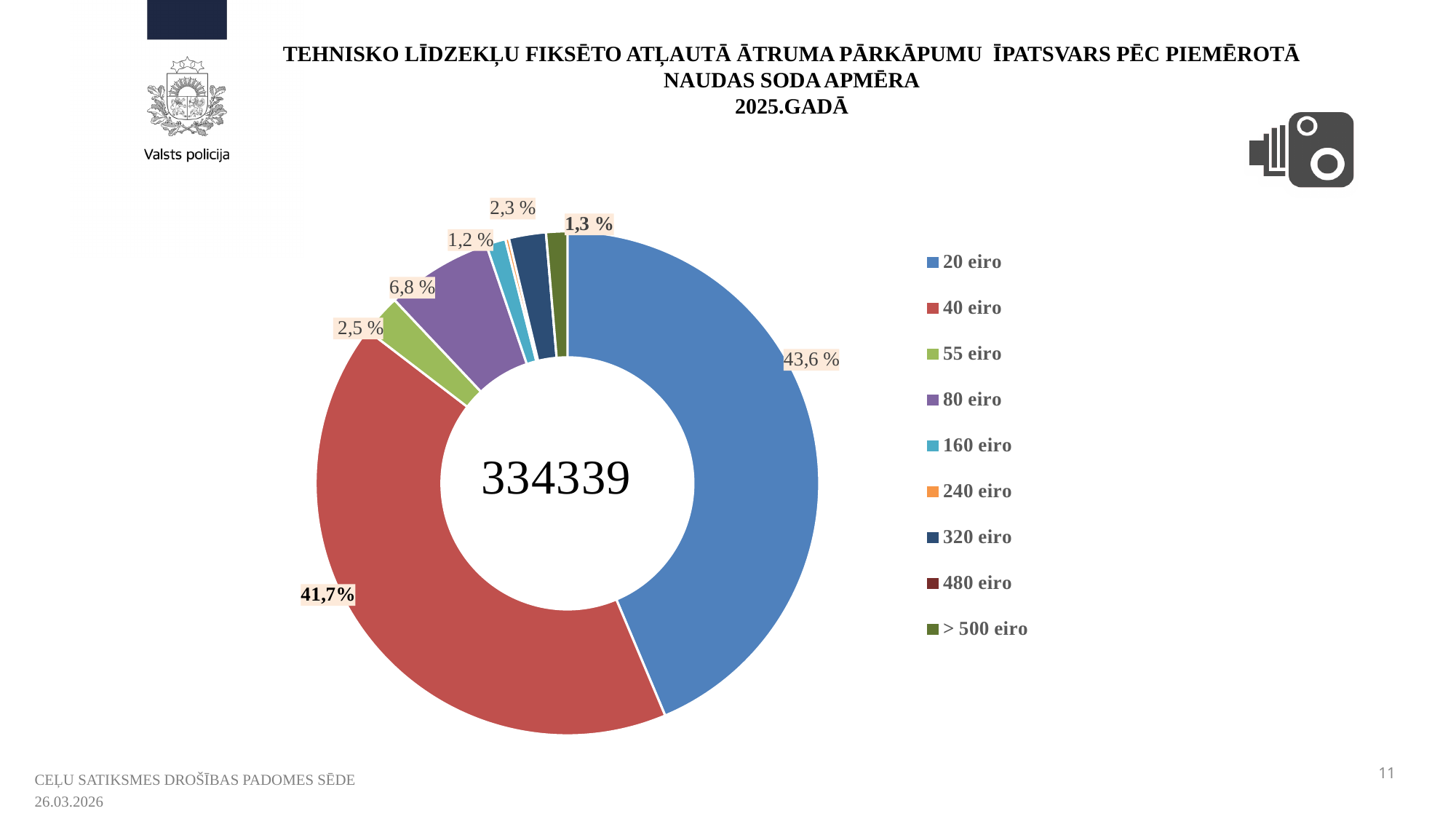
What percentage is shown for the 320 eiro slice? 2,3 % Which fine amount category has the largest share of the chart? 20 eiro What number is displayed in the centre of the chart? 334339 What share of the chart is labelled for the 40 eiro category? 41,7% What share of the chart is labelled for the 20 eiro category? 43,6 % What percentage is shown for the > 500 eiro slice? 1,3 % By how many percentage points does the 20 eiro share exceed the 40 eiro share? 1,9 What percentage is shown for the 55 eiro slice? 2,5 % What percentage is shown for the 80 eiro slice? 6,8 % What type of chart is shown on the slide? Doughnut (pie) chart How many categories does the legend list? 9 Which slice is larger, 80 eiro or 55 eiro? 80 eiro